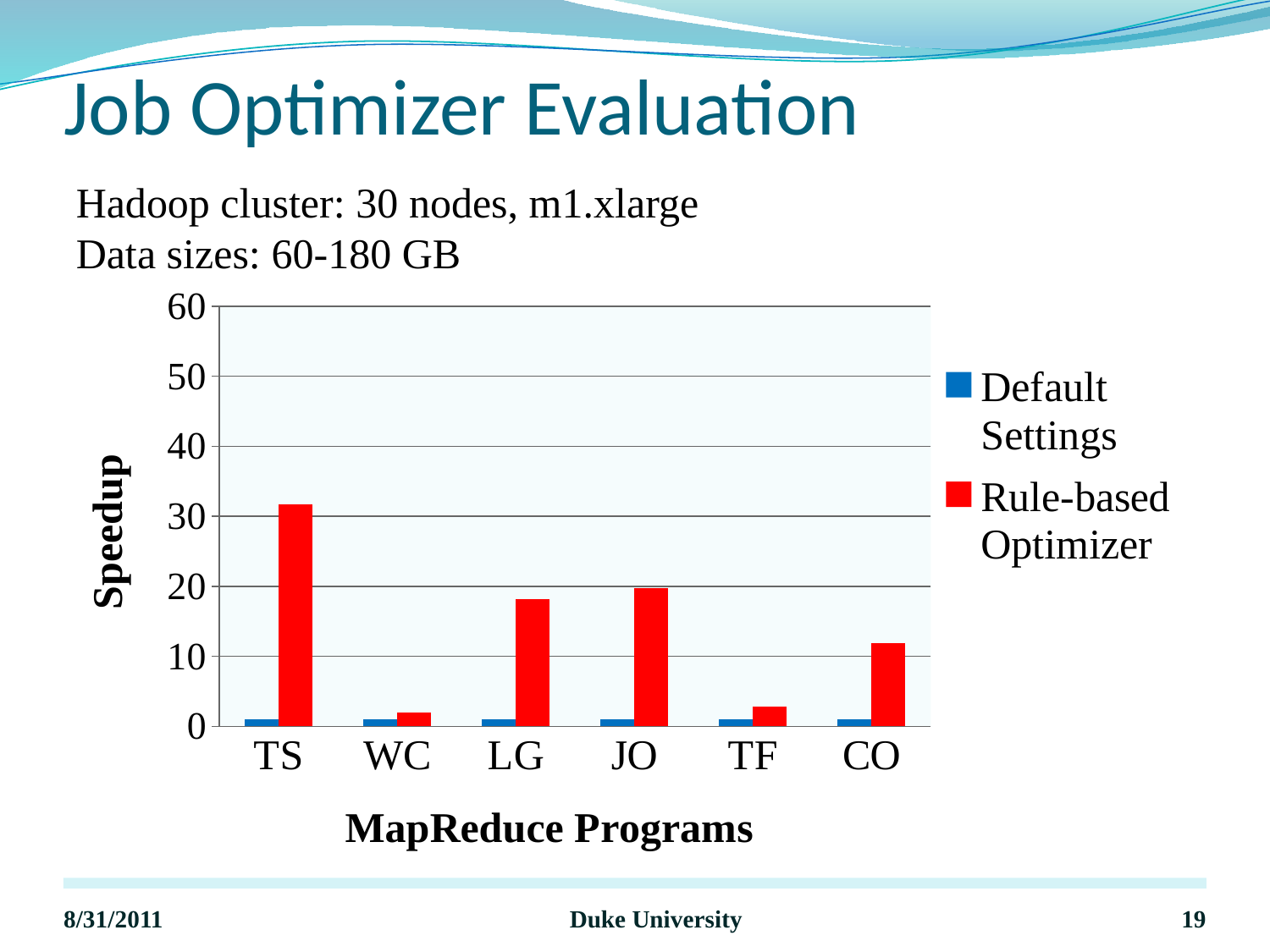
Which has a larger Rule-based Optimizer speedup, JO or TF? JO Is the Rule-based Optimizer speedup for WC greater or less than 10? less Is the Rule-based Optimizer speedup for CO greater or less than 10? greater How many series does the legend list? 2 Is the Rule-based Optimizer speedup for LG greater or less than 20? less How many MapReduce programs are shown on the x axis? 6 Which has a larger Rule-based Optimizer speedup, TS or CO? TS Which MapReduce program has the highest Rule-based Optimizer speedup? TS What is the label of the y axis? Speedup What kind of chart is shown on the slide? bar chart What is the label of the x axis? MapReduce Programs